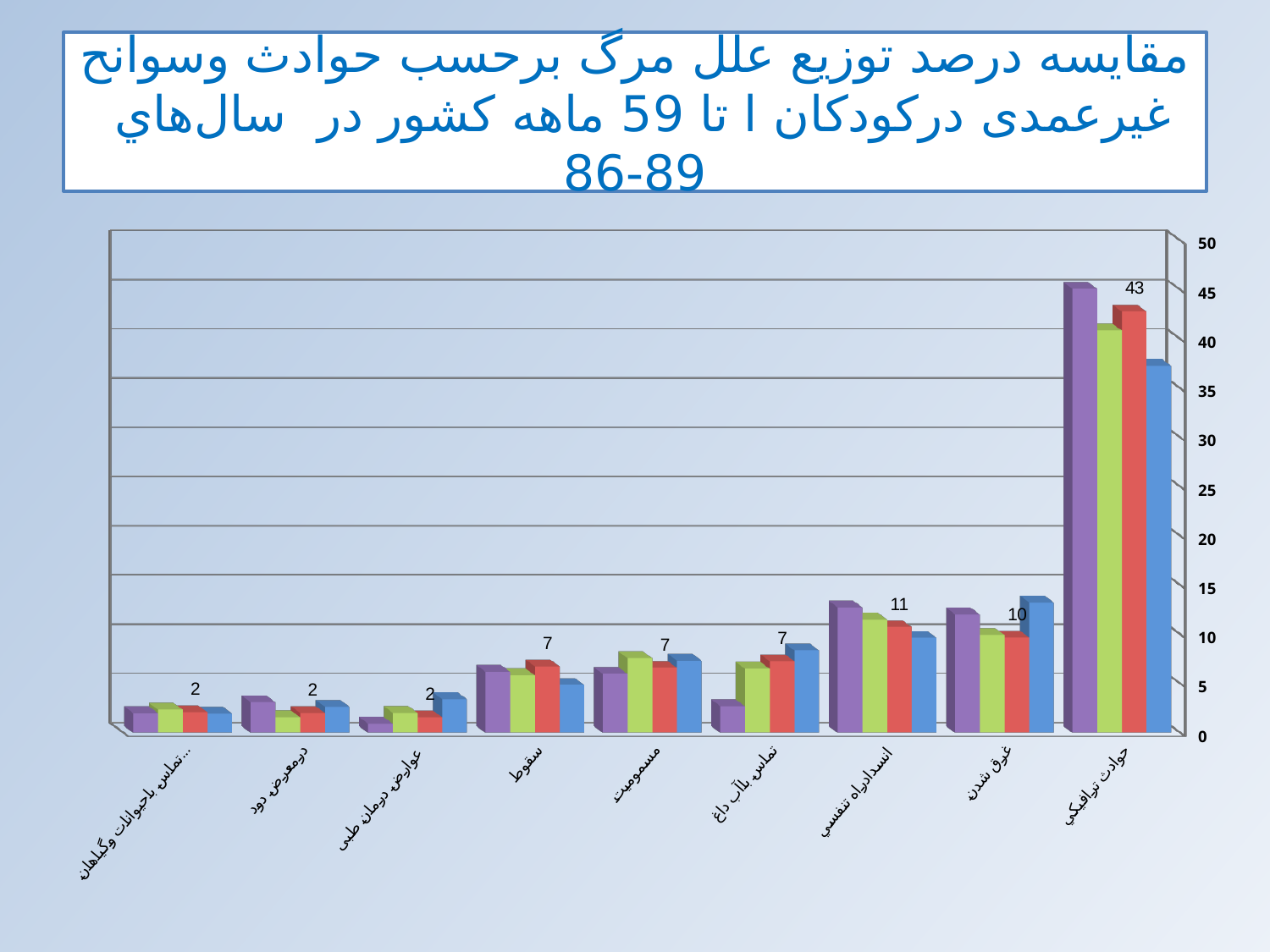
What type of chart is shown on the slide? bar chart What is the labelled value of the red bar for انسداد راه تنفسی (airway obstruction)? 11 Which is larger: the labelled red-bar value for انسداد راه تنفسی or for مسمومیت? انسداد راه تنفسی What is the labelled value of the red bar for حوادث ترافیکی (traffic accidents)? 43 Which category has the highest values in the chart? حوادث ترافیکی What is the labelled value of the red bar for سقوط (falls)? 7 What is the labelled value of the red bar for در معرض دود (exposure to smoke)? 2 What is the labelled value of the red bar for غرق شدن (drowning)? 10 Is the value of the purple bar for حوادث ترافیکی greater or less than 40? greater What is the difference between the labelled red-bar values for حوادث ترافیکی (43) and غرق شدن (10)? 33 How many categories (causes of death) are shown on the x axis of the chart? 9 Is the value of the blue bar for حوادث ترافیکی greater or less than 40? less